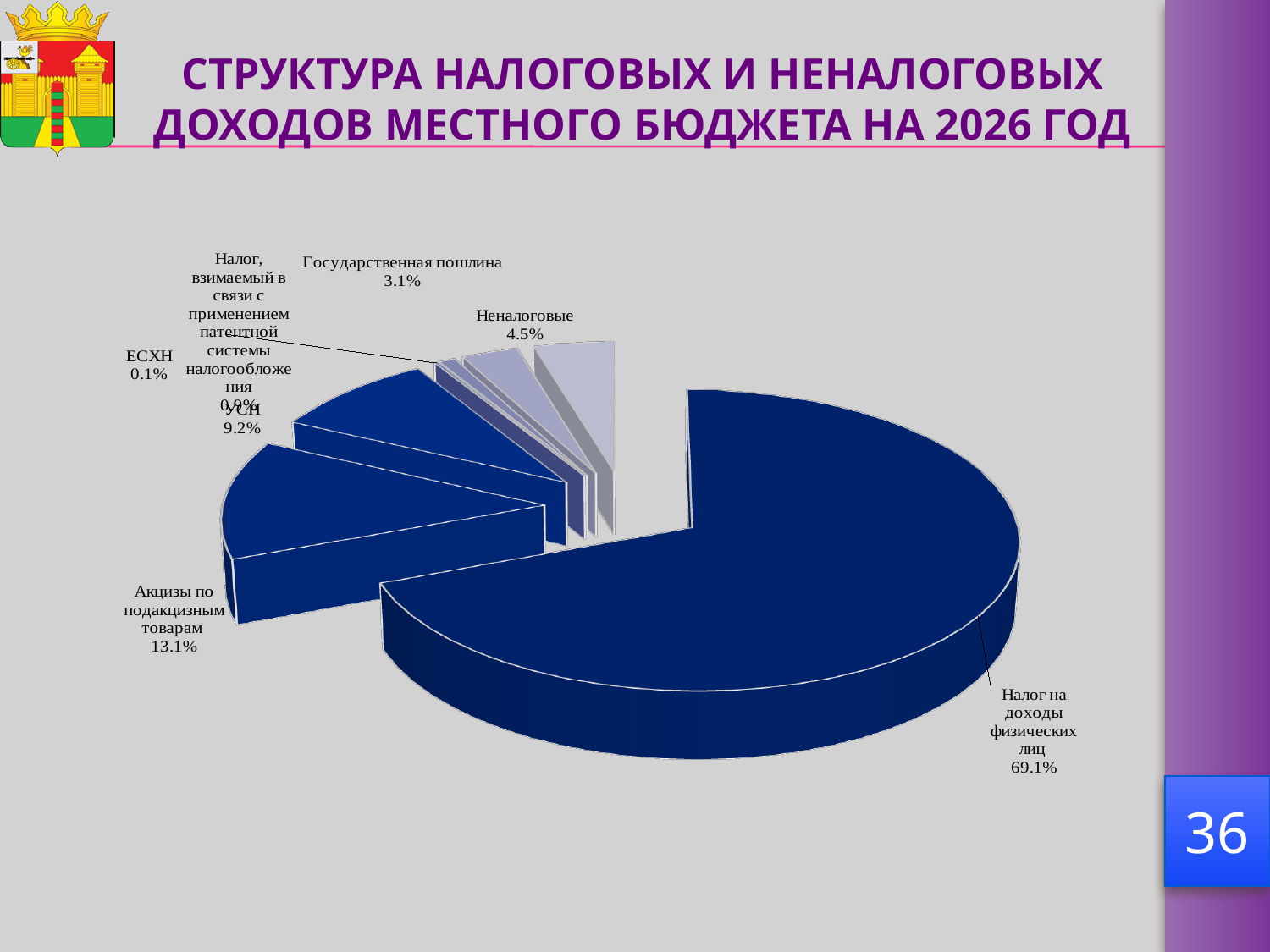
How many slices does the pie chart have? 7 What is the difference between the shares of "Акцизы по подакцизным товарам" and "УСН"? 3.9% What is the value for "Неналоговые"? 4.5% What is the value for "ЕСХН"? 0.1% What kind of chart is shown on the slide? Pie chart Which category has the smallest share of the pie? ЕСХН What share of the pie does "Налог на доходы физических лиц" have? 69.1% Which is larger: the share of "Неналоговые" or the share of "Государственная пошлина"? Неналоговые Which category has the largest share of the pie? Налог на доходы физических лиц What is the value for "Государственная пошлина"? 3.1% What is the value for "УСН"? 9.2% What is the value for "Акцизы по подакцизным товарам"? 13.1%